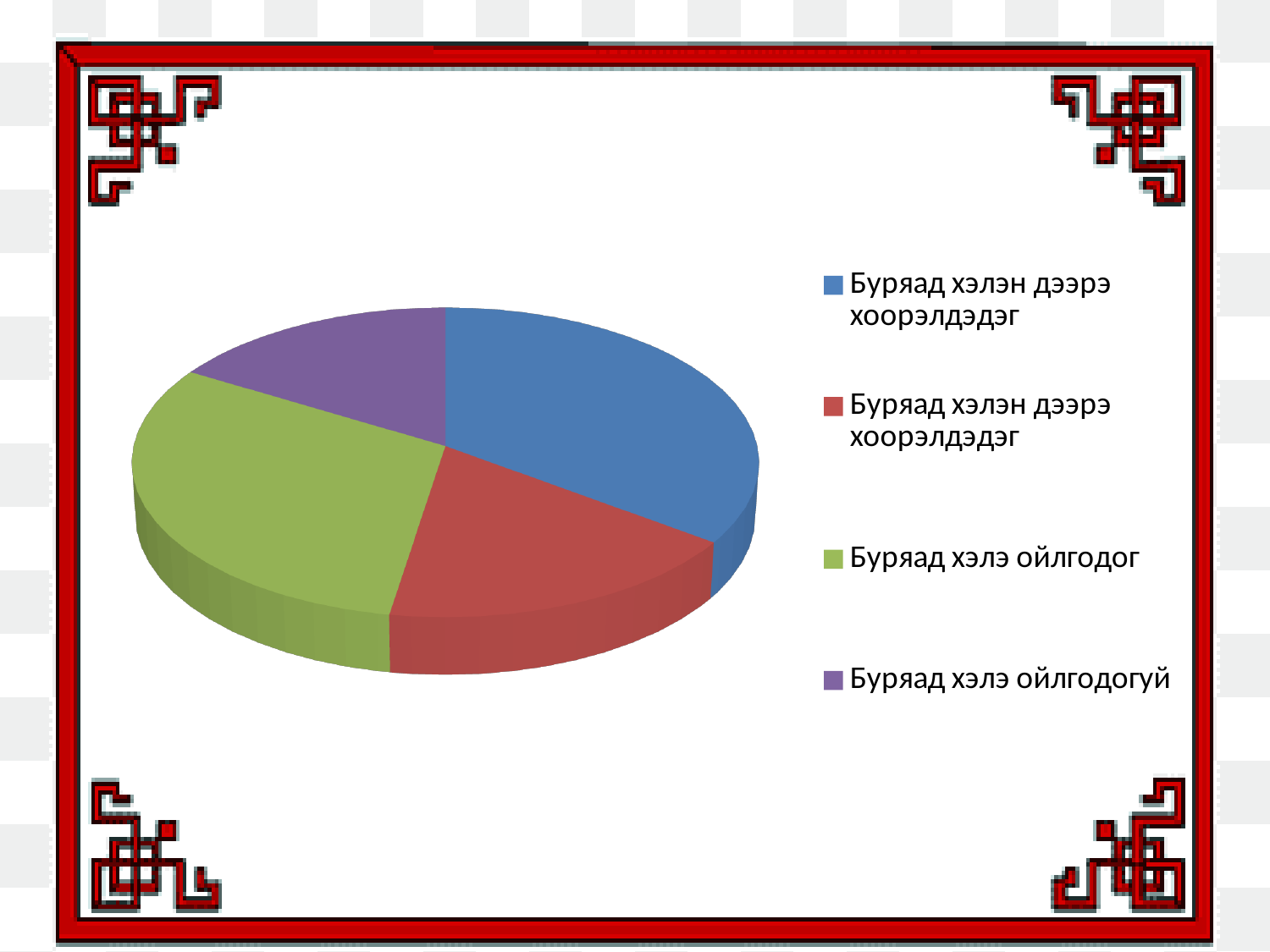
Which category has the smallest slice in the pie chart? Буряад хэлэ ойлгодогуй What colour is the slice for Буряад хэлэ ойлгодог in the pie chart? green What kind of chart is shown on the slide? pie chart Which slice is larger: the green slice (Буряад хэлэ ойлгодог) or the red slice? Буряад хэлэ ойлгодог Which slice is larger: the red slice or the purple slice (Буряад хэлэ ойлгодогуй)? the red slice Which slice is larger: the purple slice (Буряад хэлэ ойлгодогуй) or the green slice (Буряад хэлэ ойлгодог)? Буряад хэлэ ойлгодог What colour is the slice for Буряад хэлэ ойлгодогуй in the pie chart? purple How many entries does the legend of the pie chart list? 4 How many slices does the pie chart have? 4